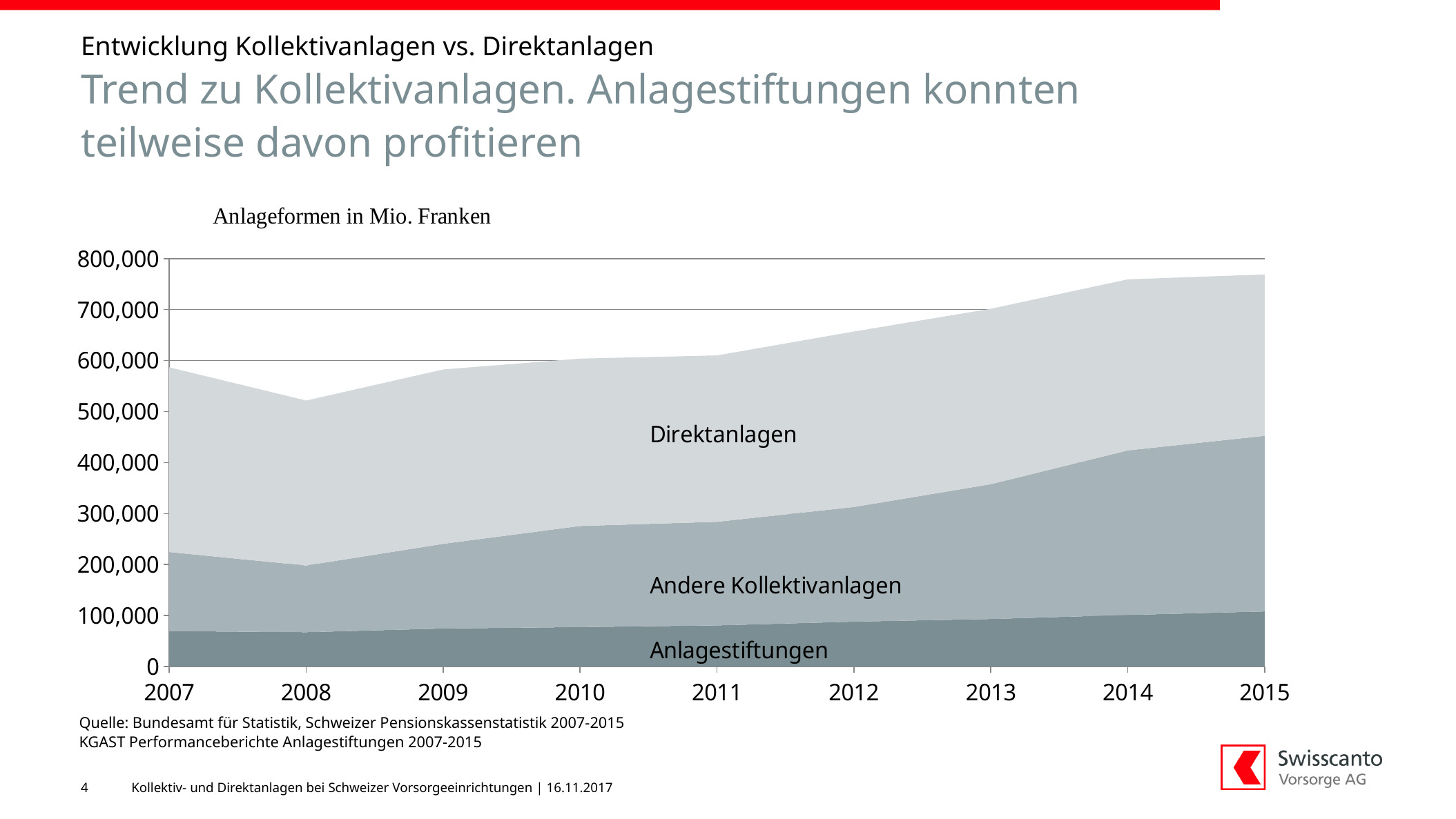
What is the title of the chart? Anlageformen in Mio. Franken In which year is the total of all investment forms lowest? 2008 Is the total of all investment forms in 2008 greater or less than 600,000? less How many series (investment forms) are labelled in the chart? 3 Which series is plotted at the bottom of the stacked area chart? Anlagestiftungen What kind of chart is shown on the slide? Stacked area chart Is the total of all investment forms larger in 2007 or in 2015? 2015 Does the total of all investment forms rise or fall from 2008 to 2015? rise How many years are shown on the x axis of the chart? 9 Is the combined value of Anlagestiftungen and Andere Kollektivanlagen in 2015 greater or less than 400,000? greater Is the value for Anlagestiftungen in 2007 greater or less than 100,000? less